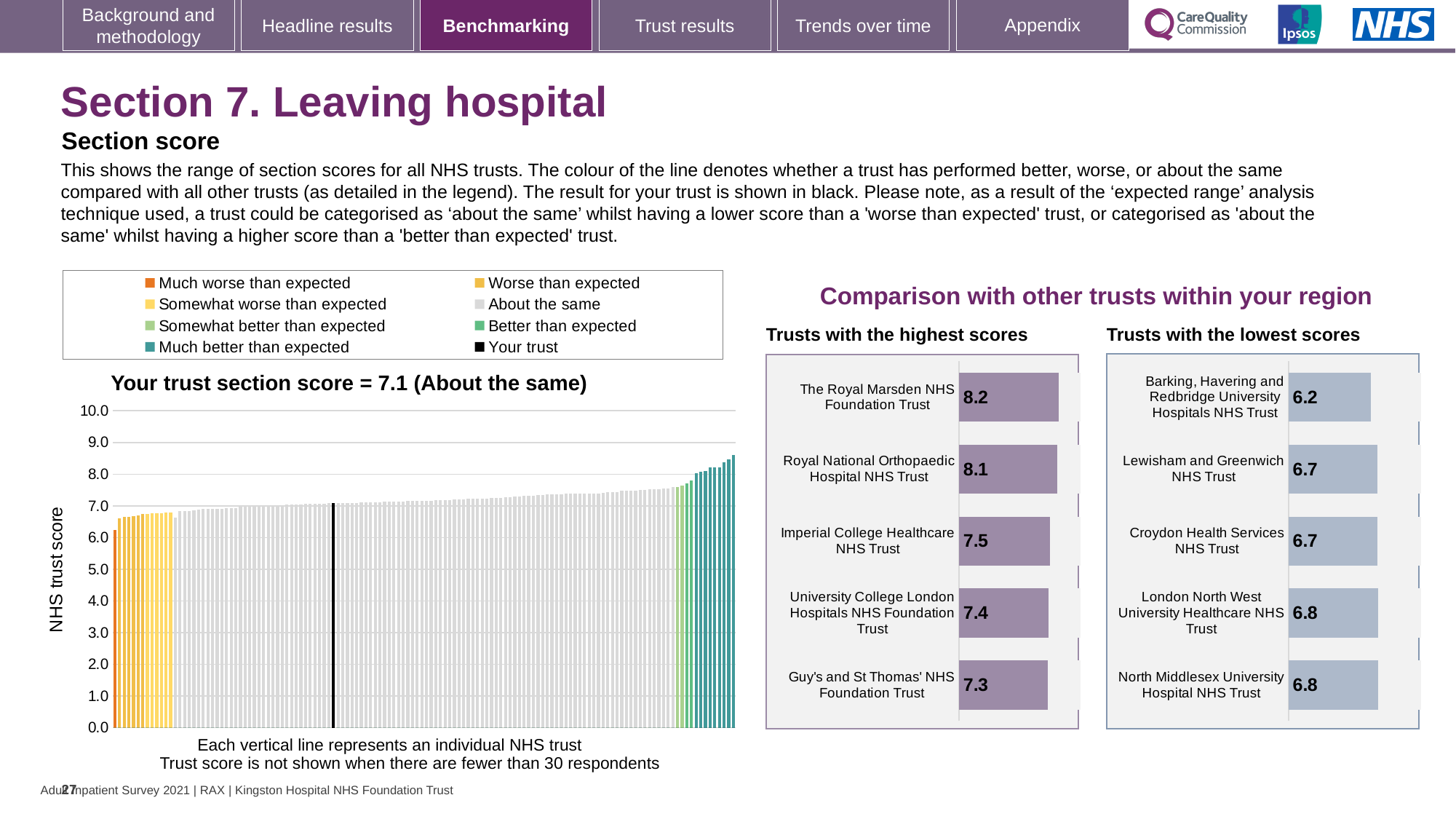
In the 'Trusts with the highest scores' chart, which trust has the highest score? The Royal Marsden NHS Foundation Trust In the 'Trusts with the lowest scores' chart, what is the score for Barking, Havering and Redbridge University Hospitals NHS Trust? 6.2 In the 'Trusts with the lowest scores' chart, what is the difference between the scores of London North West University Healthcare NHS Trust and Barking, Havering and Redbridge University Hospitals NHS Trust? 0.6 In the main section score chart on the left, what is your trust's section score? 7.1 In the 'Trusts with the highest scores' chart, what is the difference between the scores of The Royal Marsden NHS Foundation Trust and Guy's and St Thomas' NHS Foundation Trust? 0.9 In the 'Trusts with the highest scores' chart, what is the score for Imperial College Healthcare NHS Trust? 7.5 How many trusts are shown in the 'Trusts with the highest scores' chart? 5 In the 'Trusts with the lowest scores' chart, which trust has the lowest score? Barking, Havering and Redbridge University Hospitals NHS Trust In the 'Trusts with the lowest scores' chart, what is the score for Lewisham and Greenwich NHS Trust? 6.7 In the 'Trusts with the highest scores' chart, which has the higher score: Imperial College Healthcare NHS Trust or University College London Hospitals NHS Foundation Trust? Imperial College Healthcare NHS Trust In the 'Trusts with the highest scores' chart, what is the score for The Royal Marsden NHS Foundation Trust? 8.2 In the main section score chart on the left, do the trust scores rise or fall from left to right? rise